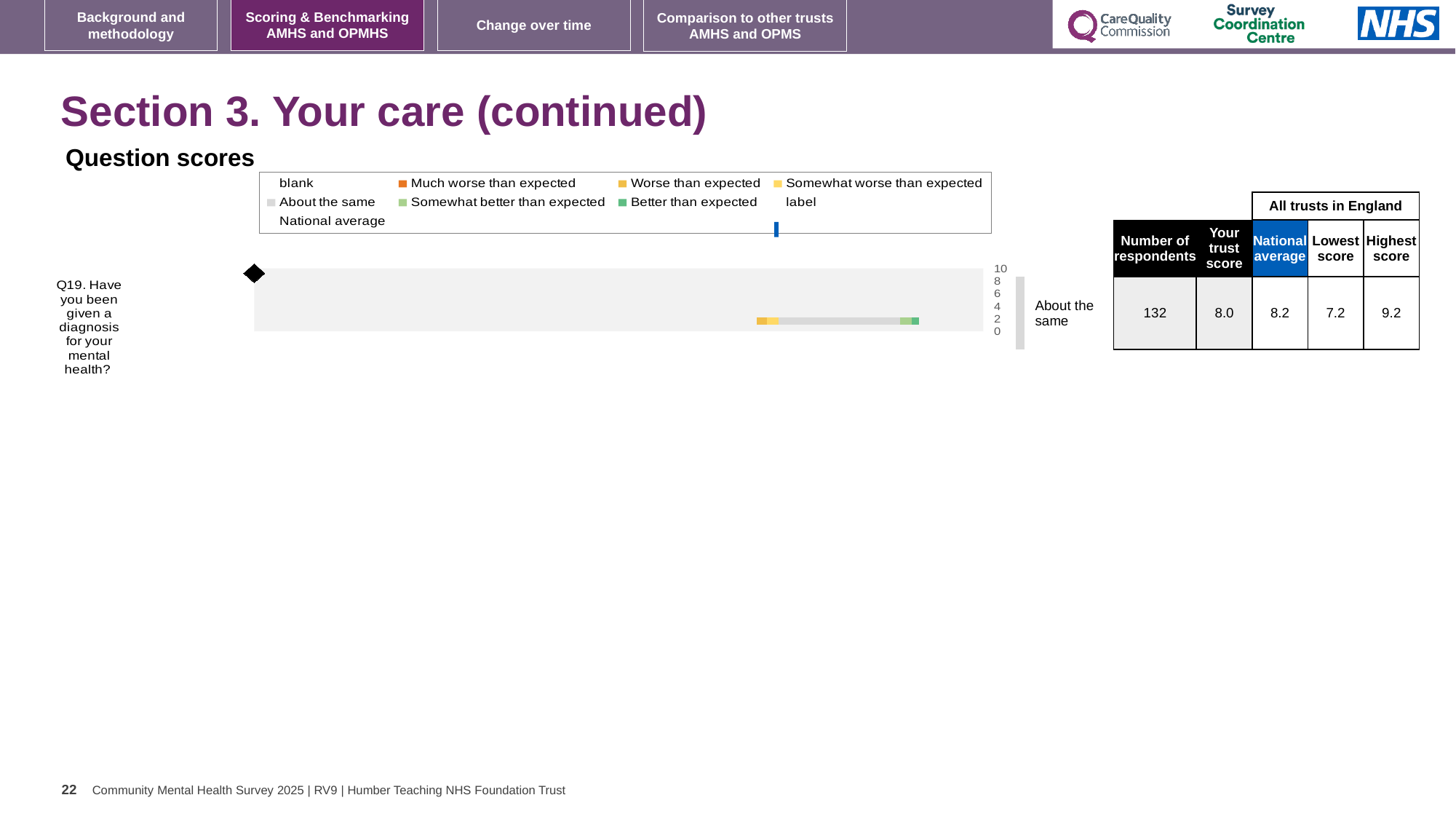
Which colour in the legend represents 'Much worse than expected'? orange What is the highest score among all trusts in England for Q19? 9.2 Which is larger for Q19: the trust's score or the national average? national average What is the difference between the highest and lowest trust scores for Q19? 2.0 What kind of chart is used to show the question scores for Q19? bar chart Is the trust's score for Q19 greater or less than 6? greater What is the trust's score for Q19 (Have you been given a diagnosis for your mental health?)? 8.0 How many respondents answered Q19? 132 What is the national average score for Q19? 8.2 What benchmarking category is shown next to the Q19 bar? About the same What is the lowest score among all trusts in England for Q19? 7.2 How many questions are plotted in the question scores chart? 1